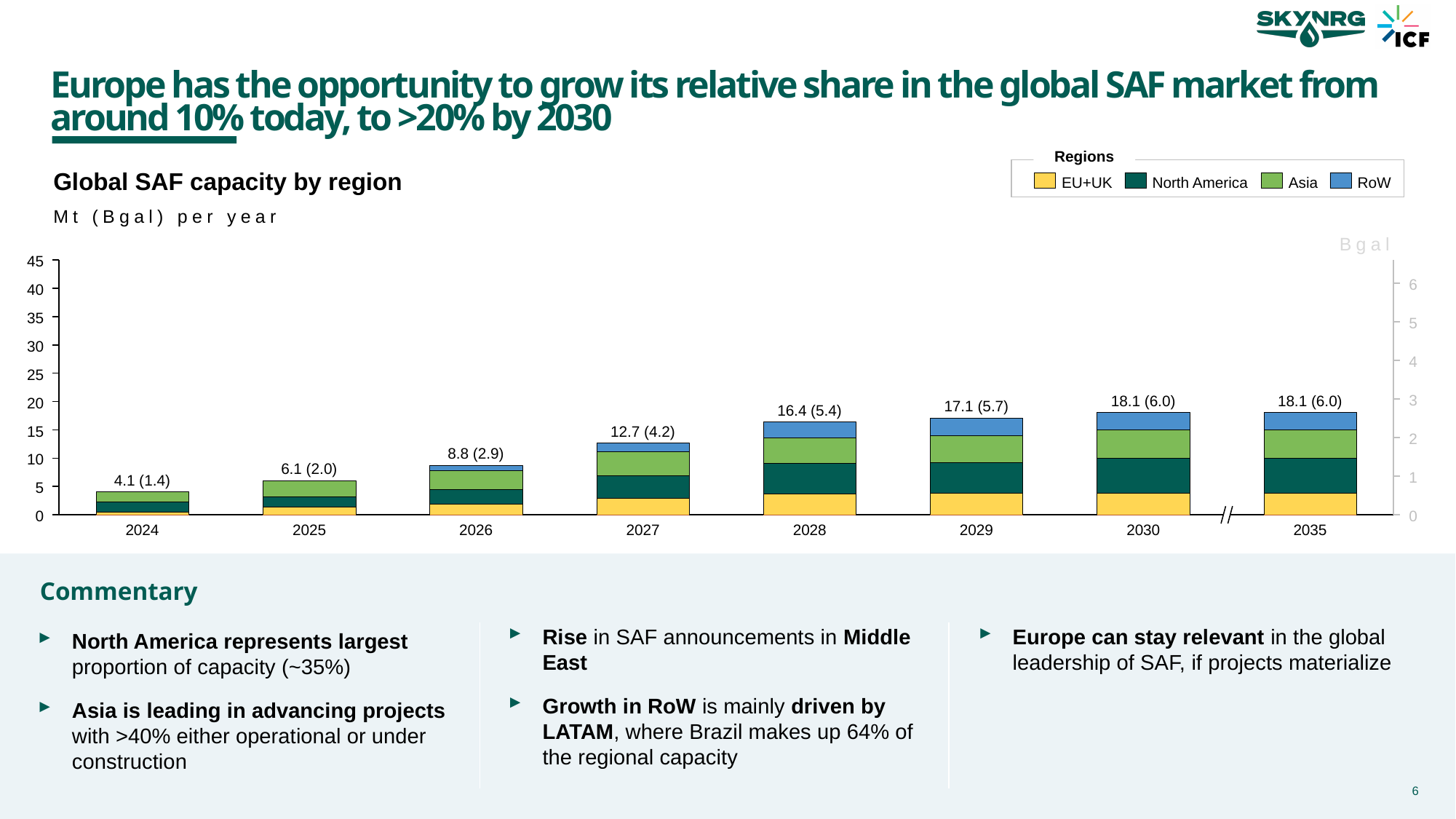
What is the total global SAF capacity labelled for 2027? 12.7 (4.2) Which region is shown in yellow in the legend? EU+UK Is the total capacity for 2028 greater or less than 15 Mt? greater Does total global SAF capacity rise or fall from 2024 to 2030? Rise What type of chart is used to show Global SAF capacity by region? Stacked bar chart Which year has the lowest total global SAF capacity? 2024 What is the difference in total capacity (Mt) between 2028 and 2025? 10.3 Which year has the larger total capacity, 2026 or 2029? 2029 What is the total global SAF capacity labelled for 2030? 18.1 (6.0) How many series does the Regions legend list? 4 What is the total global SAF capacity labelled for 2024? 4.1 (1.4) How many years are shown on the x axis of the Global SAF capacity by region chart? 8